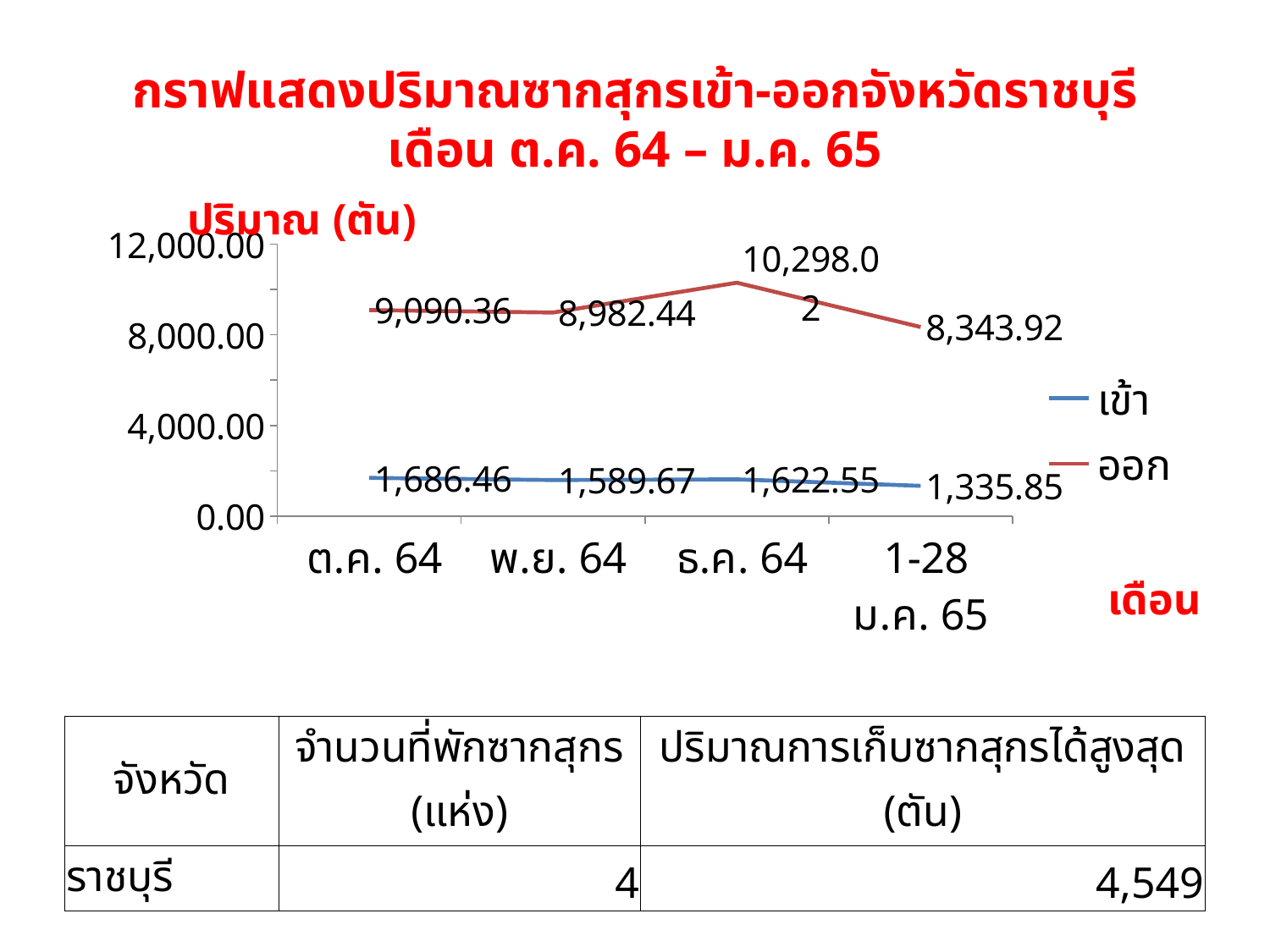
What is the value of เข้า for ต.ค. 64? 1,686.46 What type of chart is shown on the slide? line chart How many months are plotted along the x axis? 4 What is the value of ออก for 1-28 ม.ค. 65? 8,343.92 What is the value of ออก for ธ.ค. 64? 10,298.02 What is the label of the y axis? ปริมาณ (ตัน) Is the value of ออก for ธ.ค. 64 greater or less than 8,000.00? greater In which month is the เข้า series lowest? 1-28 ม.ค. 65 How many series does the legend list? 2 What is the difference between ออก and เข้า for พ.ย. 64? 7,392.77 Which is larger for ต.ค. 64, เข้า or ออก? ออก In which month is the ออก series highest? ธ.ค. 64